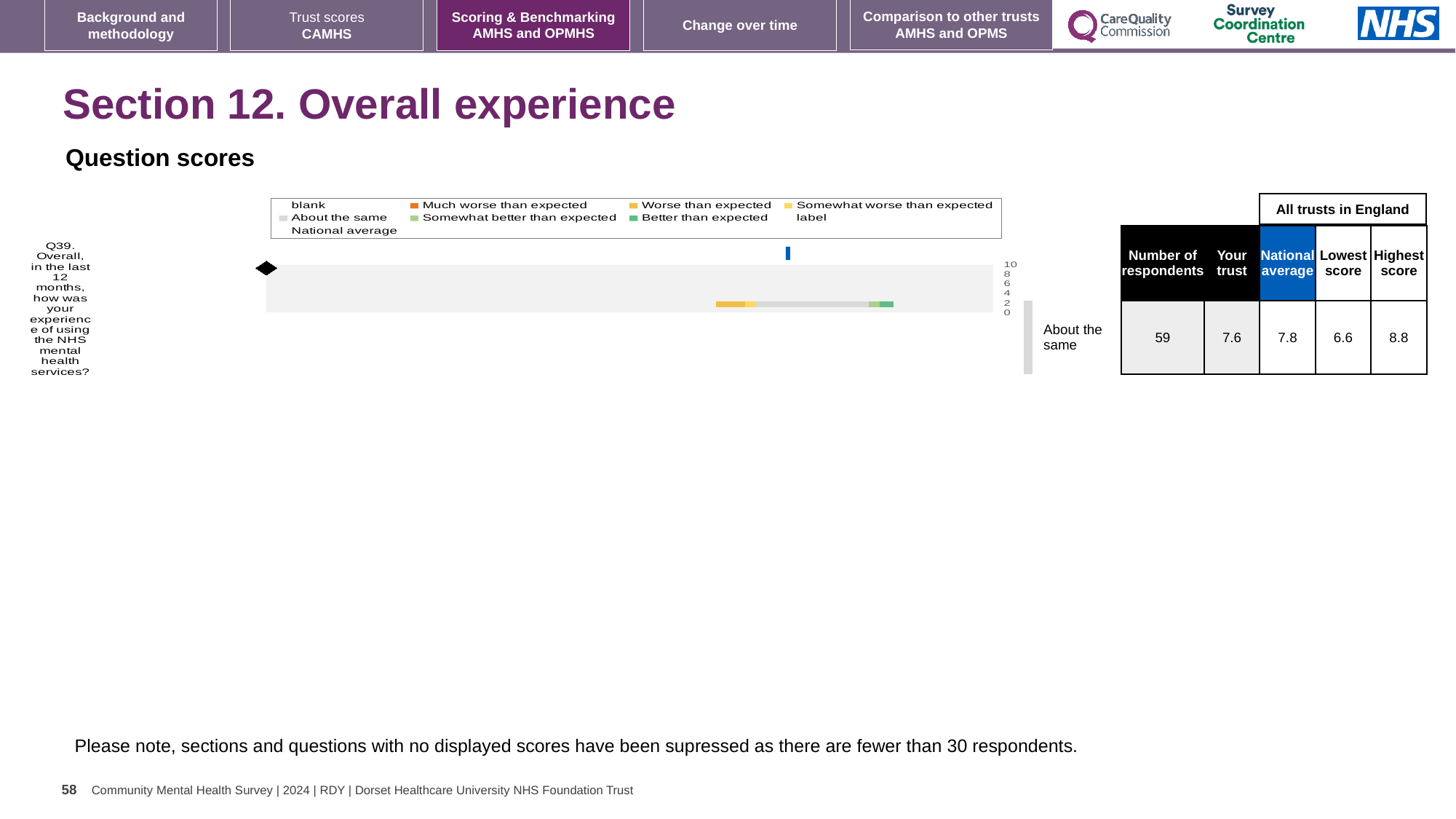
Which question is plotted in the chart? Q39. Overall, in the last 12 months, how was your experience of using the NHS mental health services? According to the table beside the chart, what is the national average score for Q39? 7.8 Which benchmark category is the trust's Q39 score placed in, as labelled next to the chart? About the same What kind of chart is shown on the slide for Q39? Bar chart How many questions are plotted in the chart? 1 What is the difference between the highest score and the lowest score for Q39 in the table beside the chart? 2.2 What is the highest value shown on the chart's axis? 10 How many respondents answered Q39, according to the table beside the chart? 59 According to the table beside the chart, what is the highest score among all trusts in England for Q39? 8.8 According to the table beside the chart, what is the lowest score among all trusts in England for Q39? 6.6 According to the table beside the chart, what is the 'Your trust' score for Q39? 7.6 Which is larger for Q39: the 'Your trust' score or the national average? National average